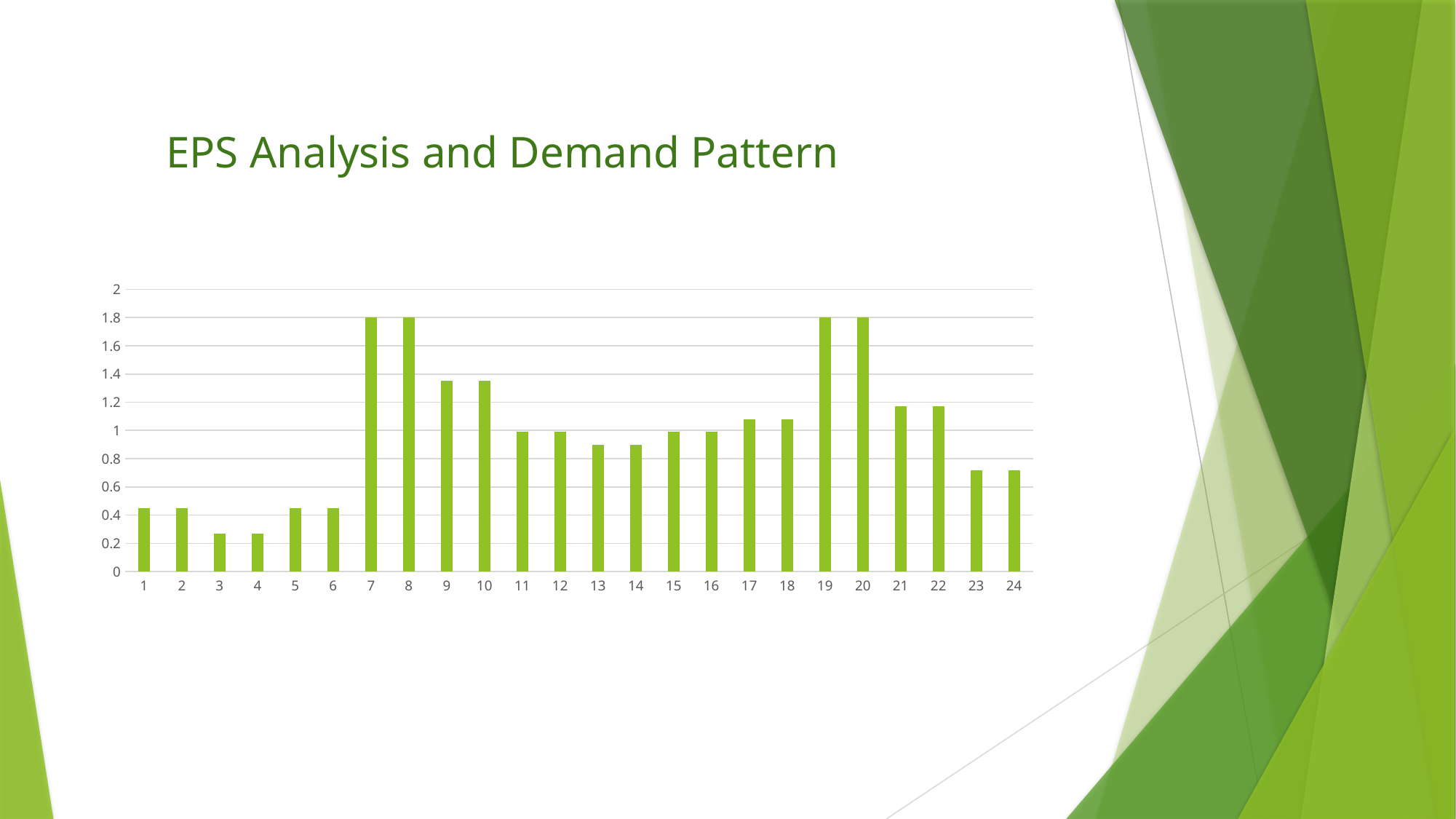
How many categories are plotted on the x axis of the chart? 24 What kind of chart is shown on the slide? bar chart Is the value for category 9 greater or less than 1.2? greater What is the value for category 19 in the chart? 1.8 What is the title of the slide containing the chart? EPS Analysis and Demand Pattern Which has the larger value, category 7 or category 9? category 7 Is the value for category 23 greater or less than 0.8? less What is the value for category 7 in the chart? 1.8 What colour are the bars in the chart? green Is the value for category 21 greater or less than 1? greater Which has the larger value, category 3 or category 5? category 5